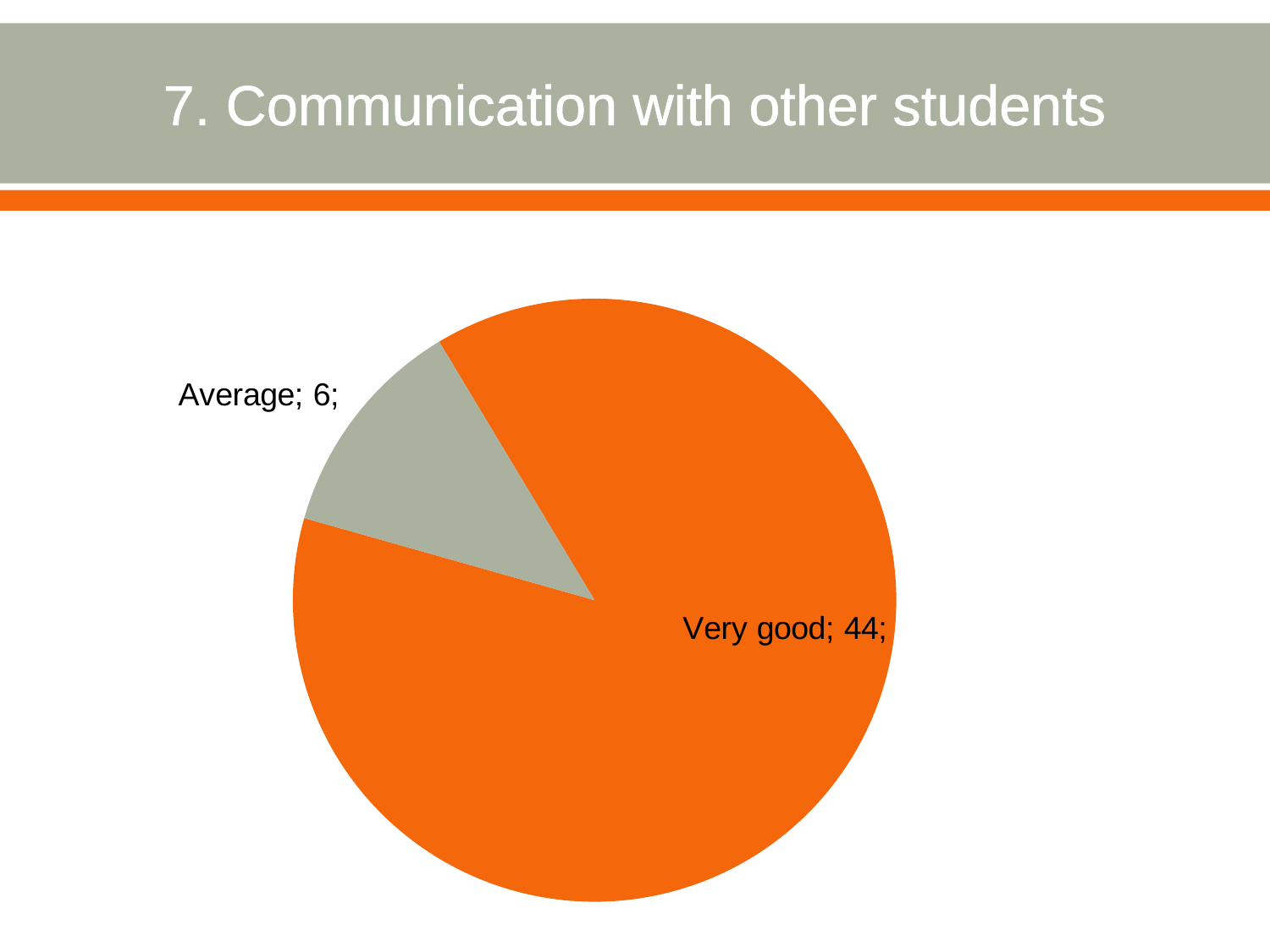
Which is larger, the value for Very good or the value for Average? Very good How many slices does the pie chart have? 2 What kind of chart is shown on the slide? pie chart What share of the pie does the Average slice represent? 12% Which category has the largest slice? Very good What is the difference between the values for Very good and Average? 38 What is the title of the slide containing the chart? 7. Communication with other students What share of the pie does the Very good slice represent? 88% Which category has the smallest slice? Average What is the total of all slices in the pie chart? 50 What is the value for Average? 6 What is the value for Very good? 44